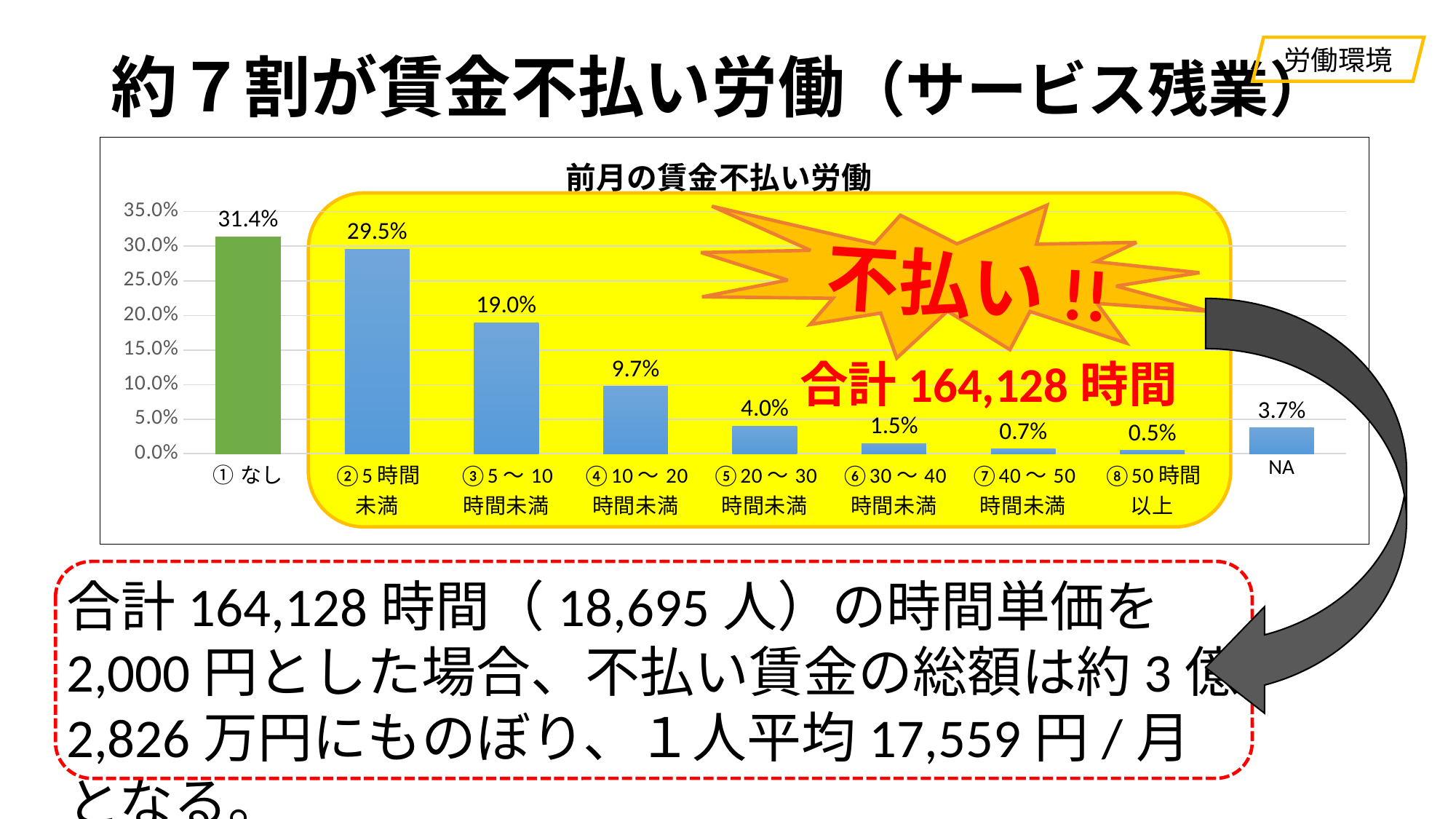
How many categories are shown on the x axis? 9 What type of chart is shown on the slide? bar chart What is the difference between the values for ②5時間未満 and ③5〜10時間未満? 10.5% Do the values rise or fall from ②5時間未満 to ⑧50時間以上? fall What is the title of the chart? 前月の賃金不払い労働 Which category has the lowest value? ⑧50時間以上 What is the value for ①なし? 31.4% What is the value for NA? 3.7% Which category has the highest value? ①なし Which is larger, the value for ⑤20〜30時間未満 or the value for NA? ⑤20〜30時間未満 What is the value for ②5時間未満? 29.5% What is the value for ④10〜20時間未満? 9.7%